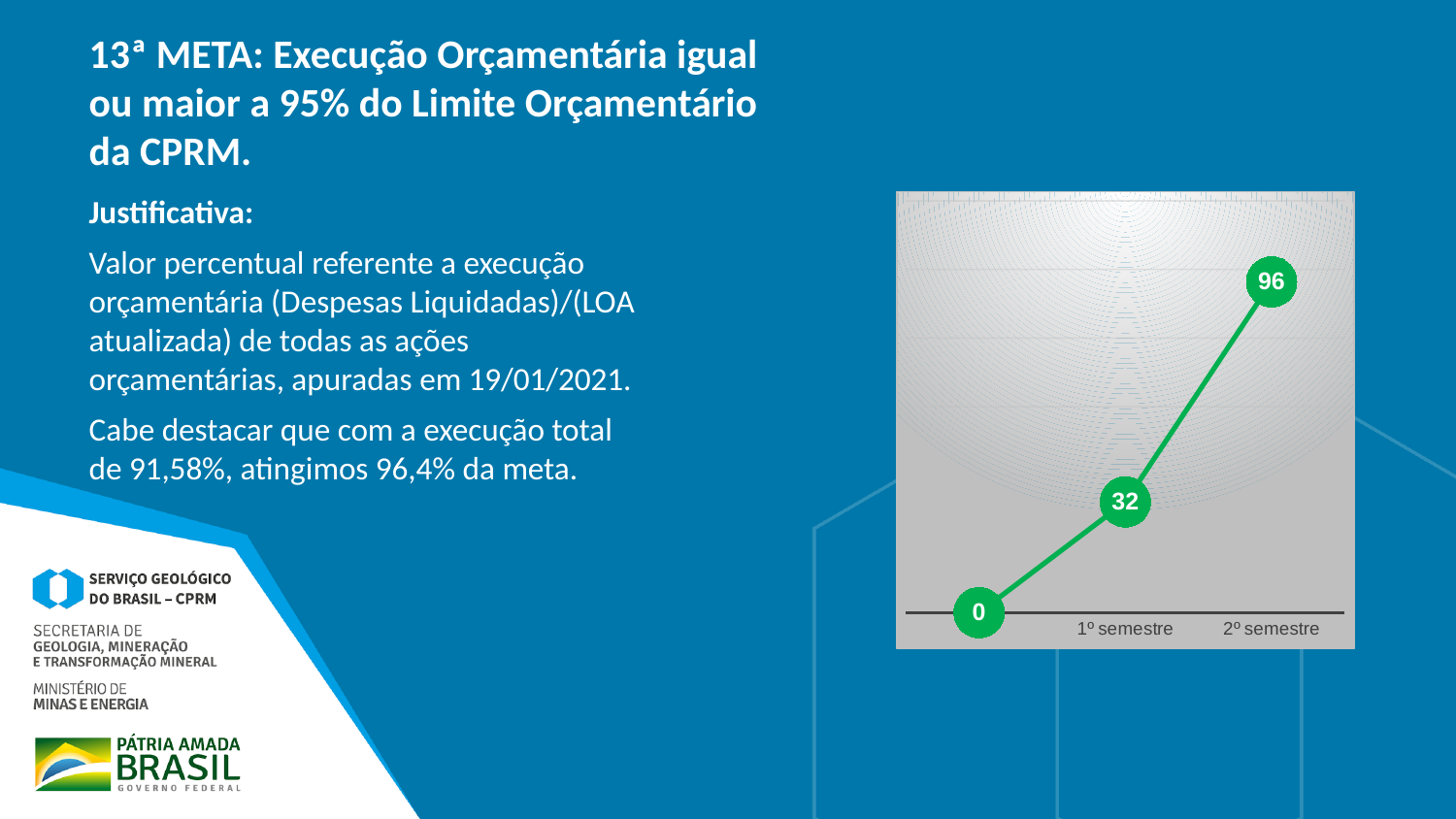
Which is larger, the value for 1º semestre or the value for 2º semestre? 2º semestre What is the value of the first (leftmost) data point on the line? 0 What colour is the line in the chart? green Which labelled category has the highest value, 1º semestre or 2º semestre? 2º semestre What is the lowest value shown on the line? 0 What is the difference between the values for 2º semestre and 1º semestre? 64 What is the value plotted for 2º semestre? 96 What is the value plotted for 1º semestre? 32 How many data points are plotted on the line? 3 Do the values rise or fall from left to right along the x axis? rise What type of chart is shown on the slide? line chart